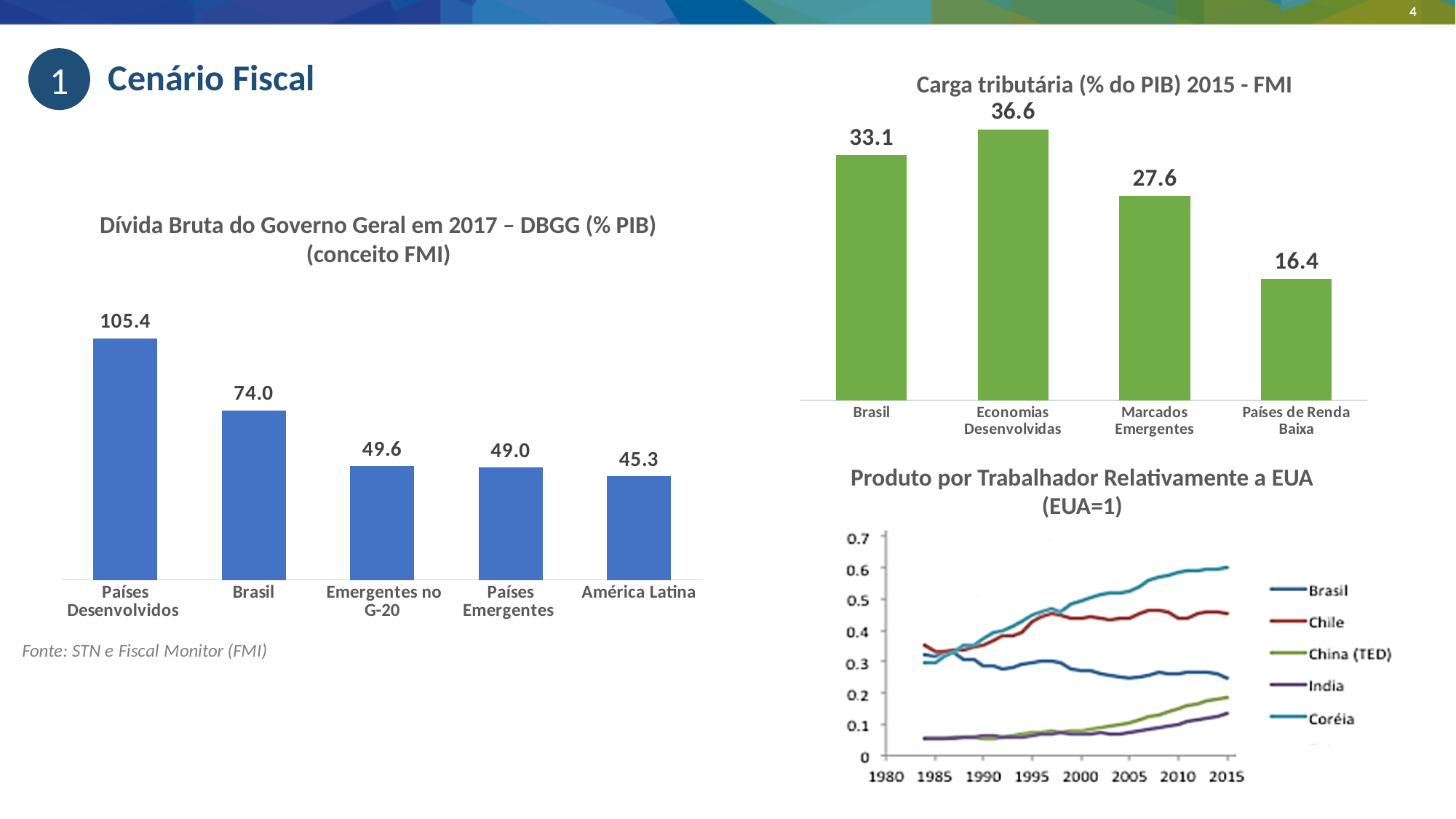
In the chart 'Produto por Trabalhador Relativamente a EUA (EUA=1)', does the Brasil line rise or fall from 1985 to 2015? Fall In the chart 'Dívida Bruta do Governo Geral em 2017 – DBGG (% PIB)', what is the difference between Países Desenvolvidos and Brasil? 31.4 In the chart 'Dívida Bruta do Governo Geral em 2017 – DBGG (% PIB)', which category has the highest value? Países Desenvolvidos In the chart 'Carga tributária (% do PIB) 2015 - FMI', which is larger: Brasil or Marcados Emergentes? Brasil What kind of chart is 'Produto por Trabalhador Relativamente a EUA (EUA=1)'? Line chart How many series does the legend of the chart 'Produto por Trabalhador Relativamente a EUA (EUA=1)' list? 5 In the chart 'Carga tributária (% do PIB) 2015 - FMI', what is the value for Economias Desenvolvidas? 36.6 In the chart 'Carga tributária (% do PIB) 2015 - FMI', what is the difference between Economias Desenvolvidas and Brasil? 3.5 In the chart 'Dívida Bruta do Governo Geral em 2017 – DBGG (% PIB)', what is the value for Brasil? 74.0 How many categories are shown in the chart 'Dívida Bruta do Governo Geral em 2017 – DBGG (% PIB)'? 5 In the chart 'Dívida Bruta do Governo Geral em 2017 – DBGG (% PIB)', which category has the lowest value? América Latina In the chart 'Carga tributária (% do PIB) 2015 - FMI', which category has the lowest value? Países de Renda Baixa